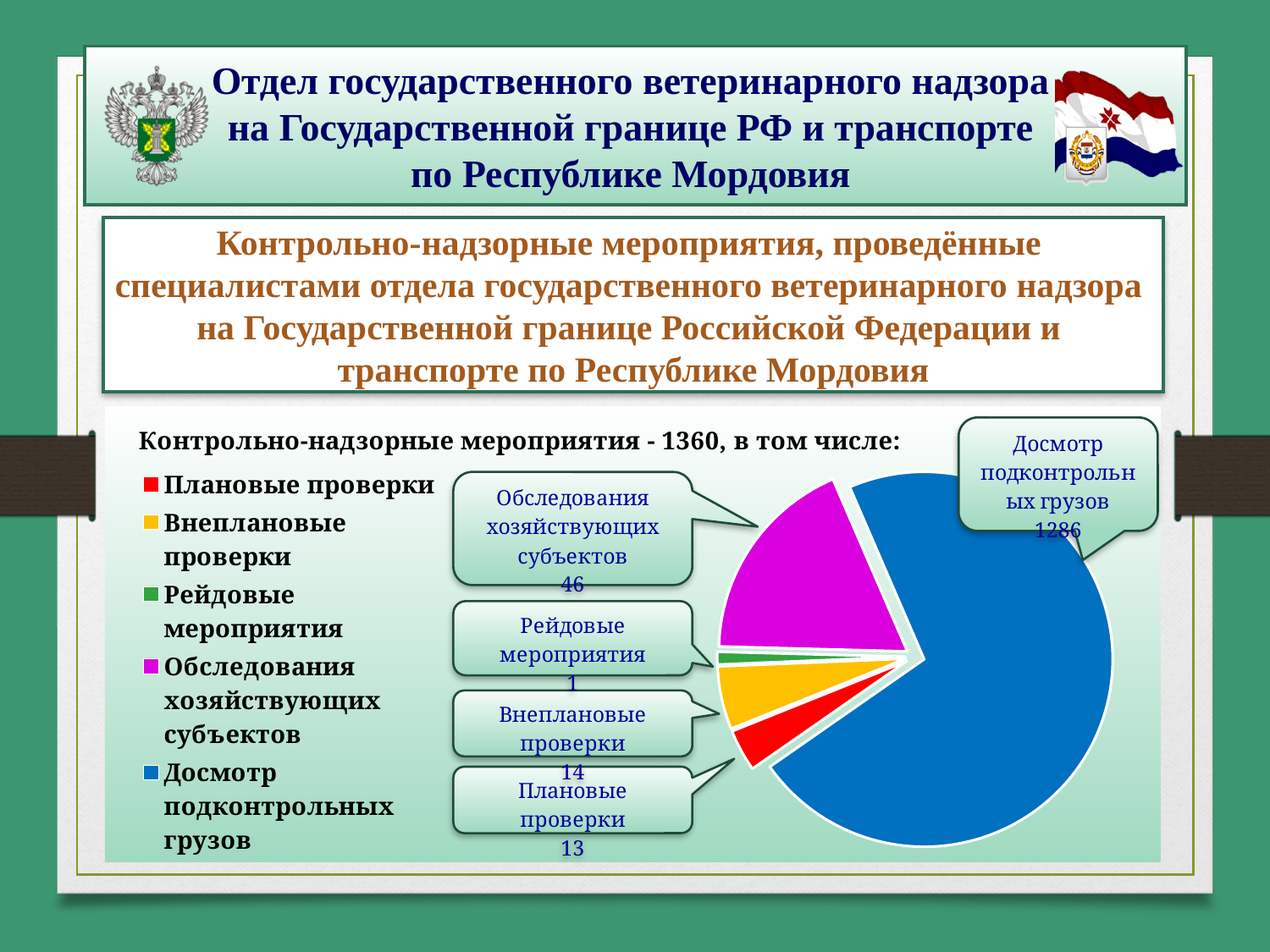
Which category has the smallest slice of the pie? Рейдовые мероприятия What is the value for Обследования хозяйствующих субъектов? 46 Which is larger, Внеплановые проверки or Плановые проверки? Внеплановые проверки What is the total number of контрольно-надзорные мероприятия stated on the slide? 1360 What is the value for Внеплановые проверки? 14 What is the value for Рейдовые мероприятия? 1 How many categories does the pie chart have? 5 What type of chart is shown on the slide? pie chart What colour is the slice for Обследования хозяйствующих субъектов? magenta What is the value for Досмотр подконтрольных грузов? 1286 Which category has the largest slice of the pie? Досмотр подконтрольных грузов What is the difference between Досмотр подконтрольных грузов and Обследования хозяйствующих субъектов? 1240